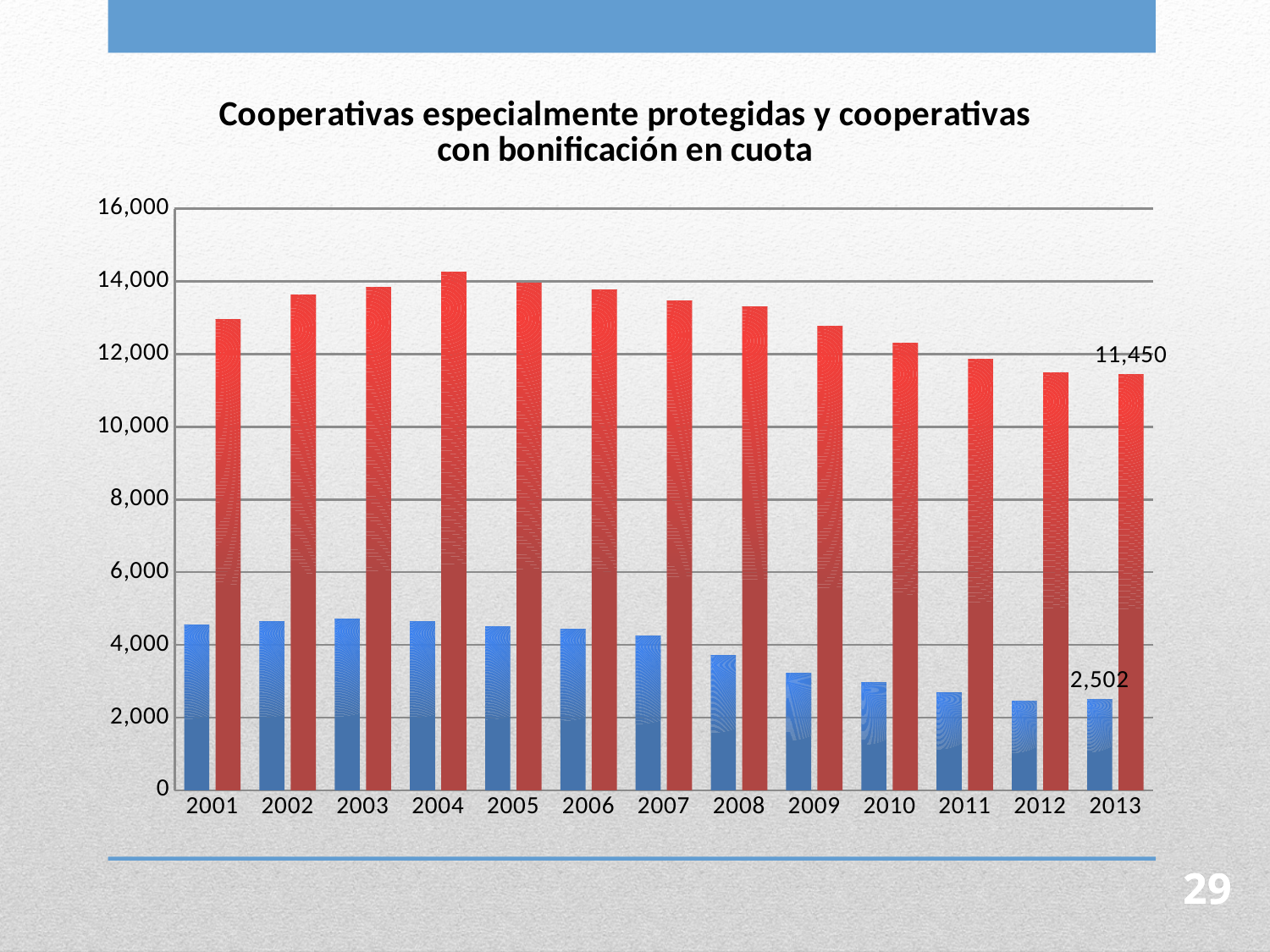
What is the difference between the red bar and the blue bar in 2013? 8,948 In which year is the red bar highest? 2004 Is the value of the red bar for 2001 greater or less than 12,000? greater What kind of chart is shown on the slide? Bar chart How many years are shown on the x axis? 13 Is the value of the blue bar for 2001 greater or less than 4,000? greater Which is larger, the red bar for 2001 or the red bar for 2004? 2004 Is the value of the blue bar for 2008 greater or less than 4,000? less What is the value of the red bar for 2013? 11,450 Do the red bars rise or fall from 2004 to 2013? Fall What is the value of the blue bar for 2013? 2,502